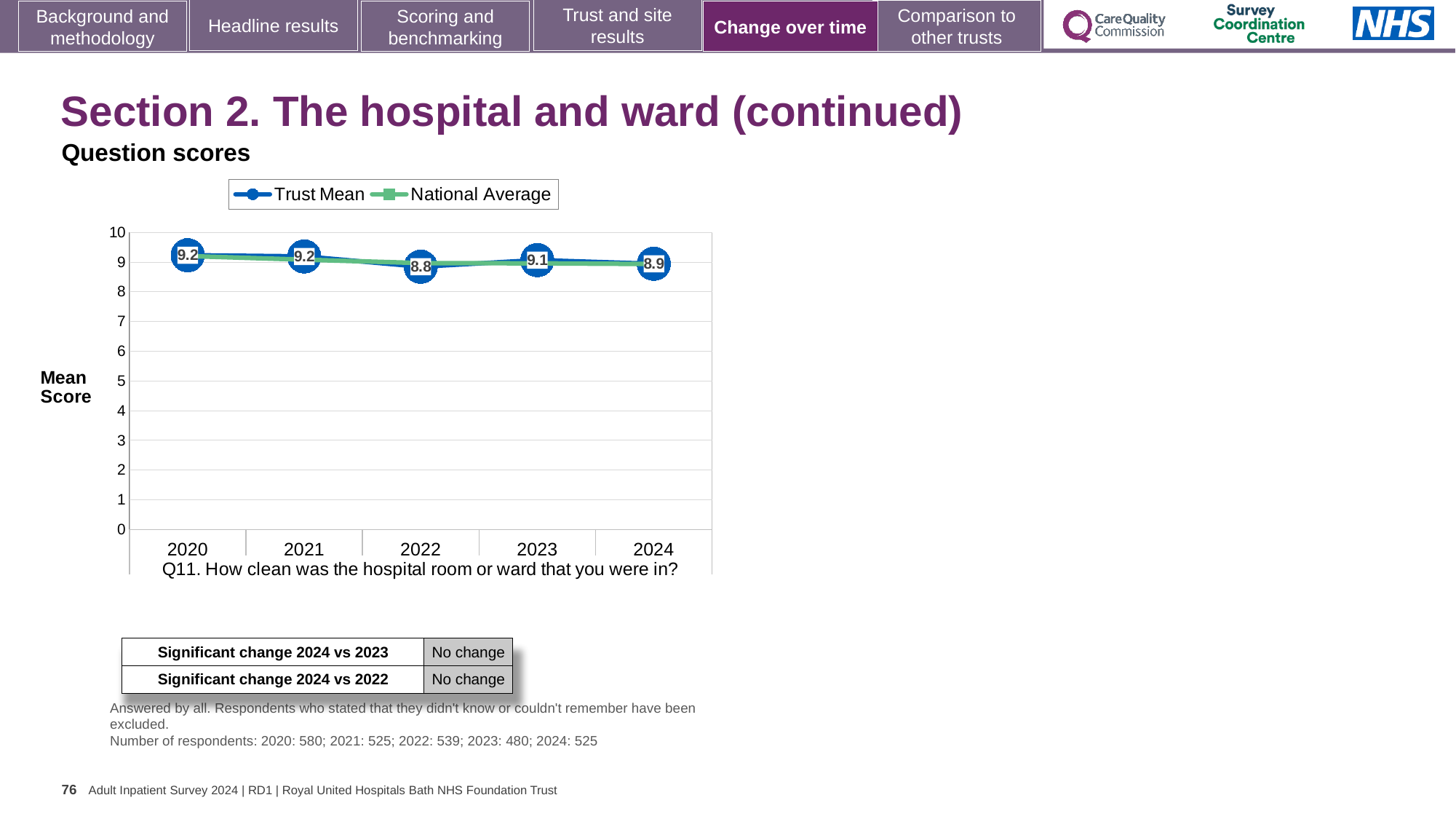
In which year is the Trust Mean lowest? 2022 Which year has the larger Trust Mean, 2022 or 2023? 2023 Is the National Average value for 2020 greater or less than 8? greater Does the Trust Mean rise or fall from 2021 to 2022? fall What is the difference between the Trust Mean in 2021 and in 2022? 0.4 What is the Trust Mean value for 2024? 8.9 What kind of chart is shown on the slide? line chart How many years are plotted on the x axis? 5 How many series does the legend list? 2 What is the difference between the Trust Mean in 2023 and in 2024? 0.2 What is the Trust Mean value for 2022? 8.8 What is the Trust Mean value for 2020? 9.2